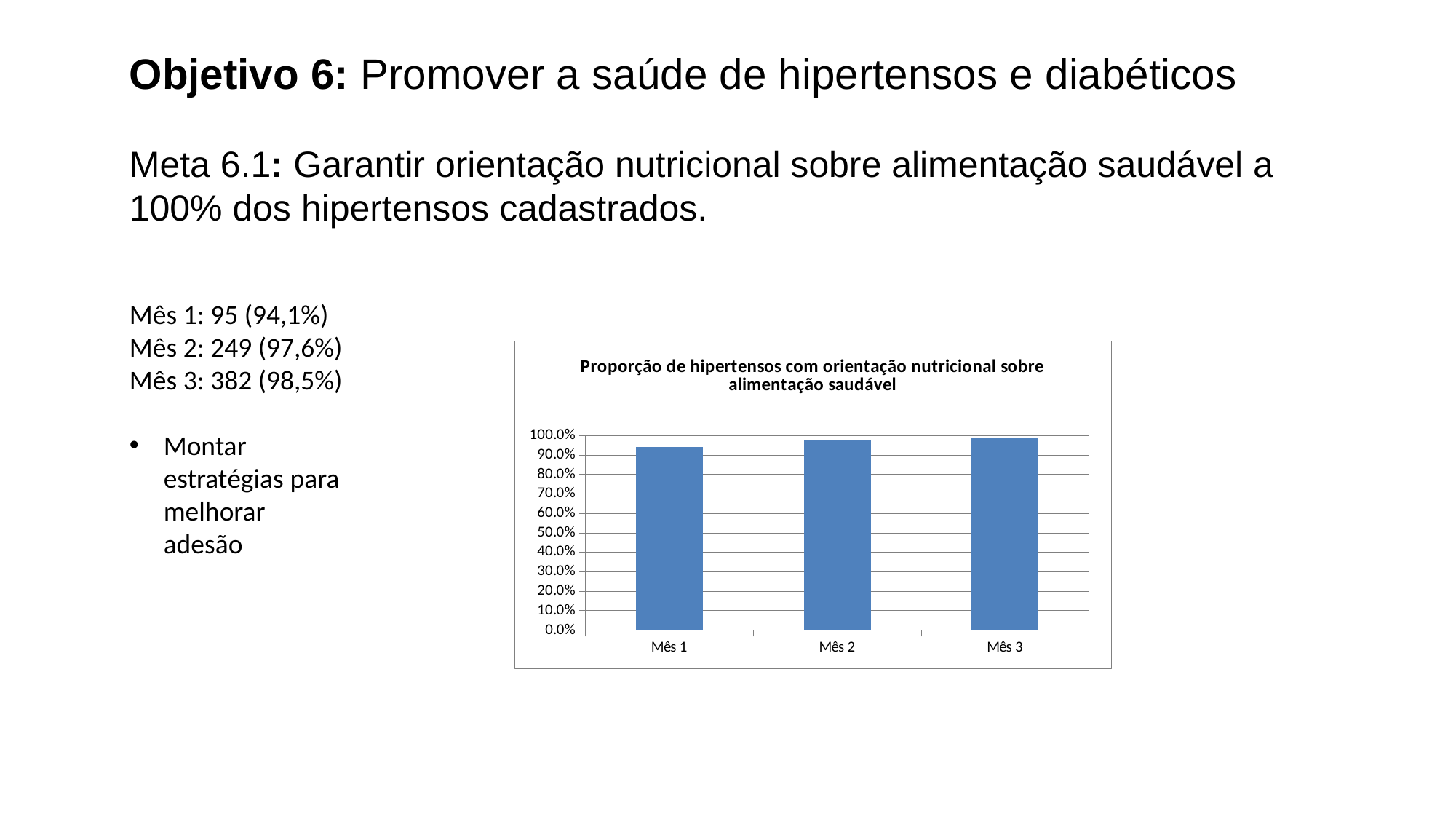
How many categories are plotted on the x axis of the chart? 3 Is the value for Mês 3 greater or less than 80.0%? greater What is the title of the chart? Proporção de hipertensos com orientação nutricional sobre alimentação saudável Which month has the lowest bar in the chart? Mês 1 Do the values in the chart rise or fall from Mês 1 to Mês 3? rise Is the value for Mês 2 greater or less than 90.0%? greater What kind of chart is shown on the slide? bar chart What is the highest value shown on the chart's y axis? 100.0% Which is larger in the chart, the value for Mês 1 or the value for Mês 3? Mês 3 Is the value for Mês 1 greater or less than 90.0%? greater